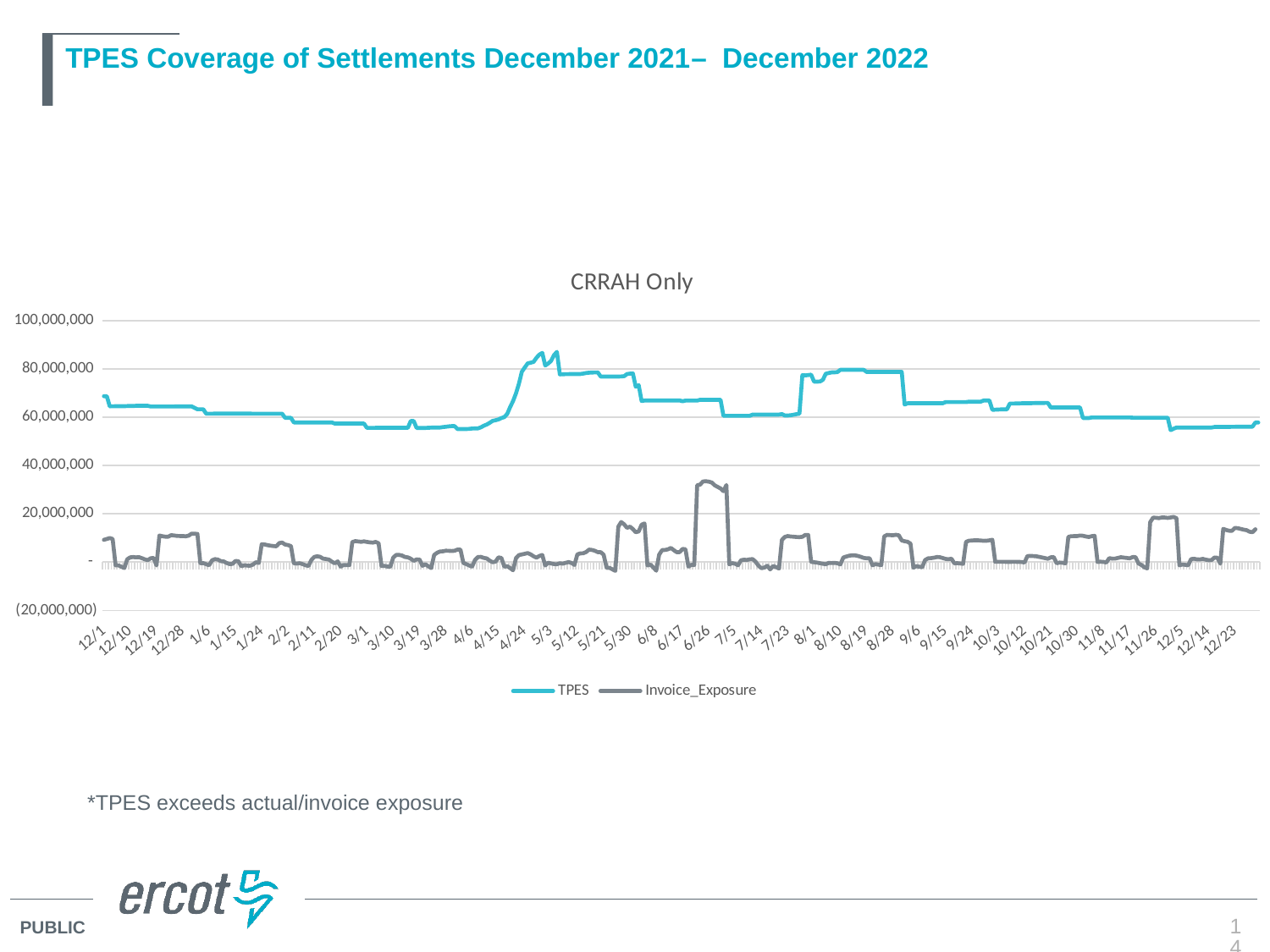
Which series is higher on 6/26, TPES or Invoice_Exposure? TPES Is the TPES value on 12/1 greater or less than 60,000,000? greater Is the Invoice_Exposure value around 6/26 greater or less than 20,000,000? greater How many series does the legend of the chart list? 2 What kind of chart is shown on the slide? line chart Is the peak TPES value around 5/3 greater or less than 80,000,000? greater Does the TPES line rise or fall between 4/6 and 5/3? rise Which series reaches the highest value on the chart? TPES Which two series are listed in the chart legend? TPES and Invoice_Exposure What is the title of the chart? CRRAH Only